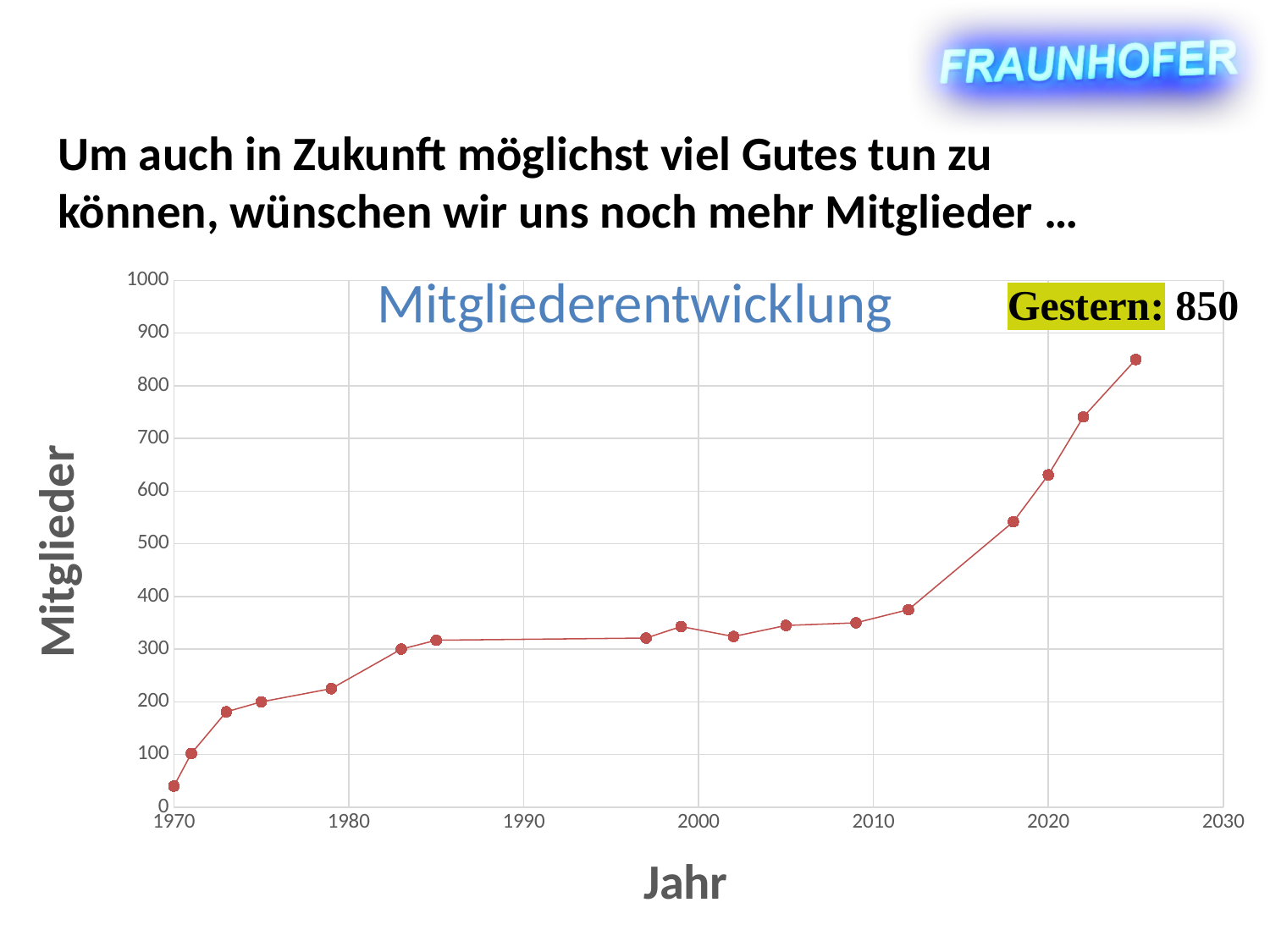
Is the value for 2020 greater or less than 600? greater How many data points are plotted on the chart? 17 What kind of chart is shown on the slide? line chart In which year is the number of Mitglieder lowest? 1970 Overall, do the values rise or fall from 1970 to 2025? rise Which is larger, the value for 2020 or the value for 2012? 2020 What is the title of the chart? Mitgliederentwicklung In which year is the number of Mitglieder highest? 2025 Is the value for 2022 greater or less than 700? greater Is the value for 1970 greater or less than 100? less What is the label of the x axis of the chart? Jahr